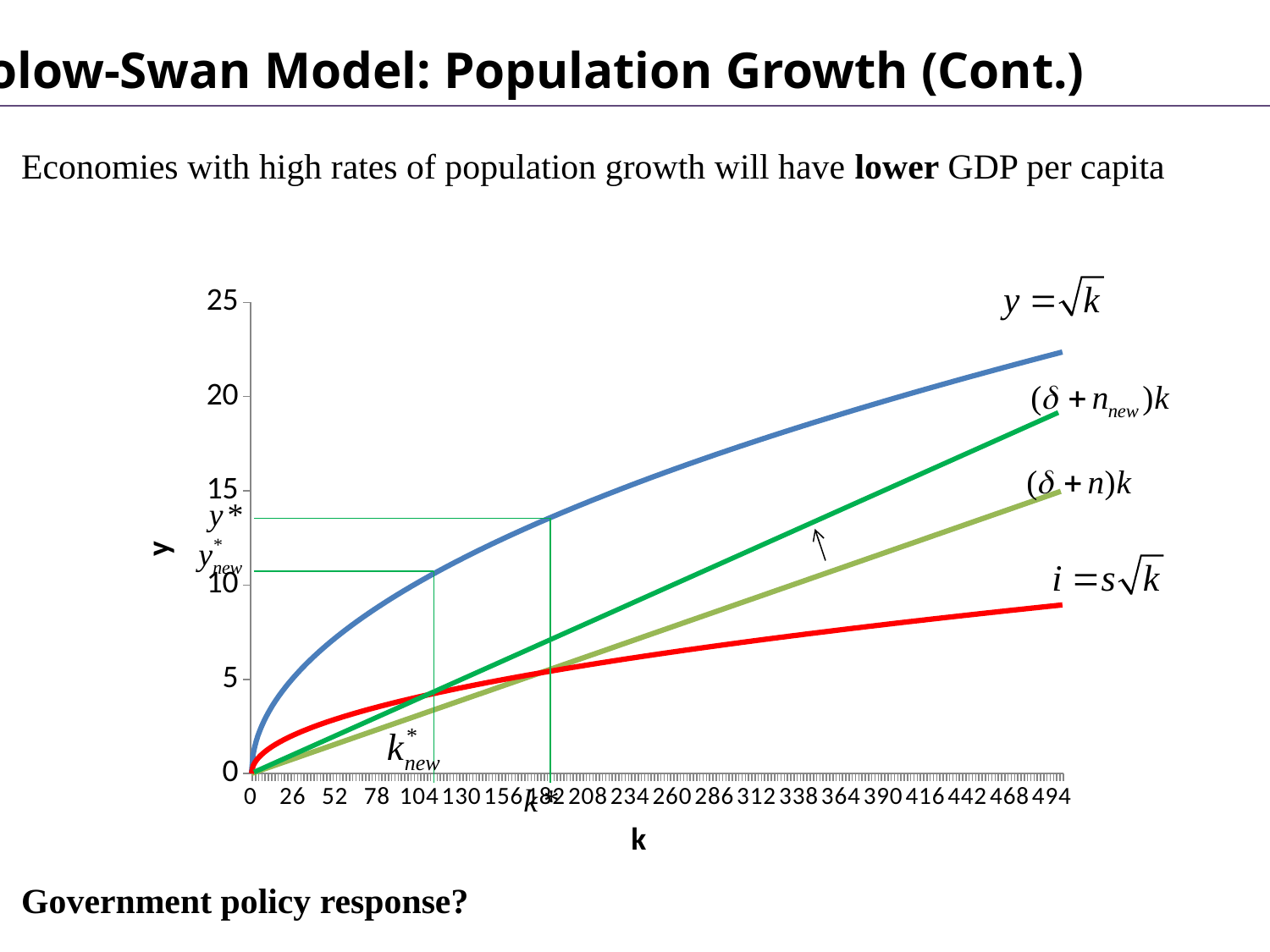
What kind of chart is shown on the slide? line chart Which curve has the lowest value at the right end of the chart (k = 494)? i = s√k Is the value of the (δ + n_new)k line at k = 494 greater or less than 15? greater How many curves are plotted on the chart? 4 What is the highest tick value shown on the vertical axis? 25 Is the value of the y = √k curve at k = 494 greater or less than 20? greater Does the y = √k curve rise or fall as k increases? rise Which curve reaches the highest value at the right end of the chart (k = 494)? y = √k What is the label of the horizontal axis? k Which line is steeper, (δ + n_new)k or (δ + n)k? (δ + n_new)k Is the value of the i = s√k curve at k = 494 greater or less than 10? less